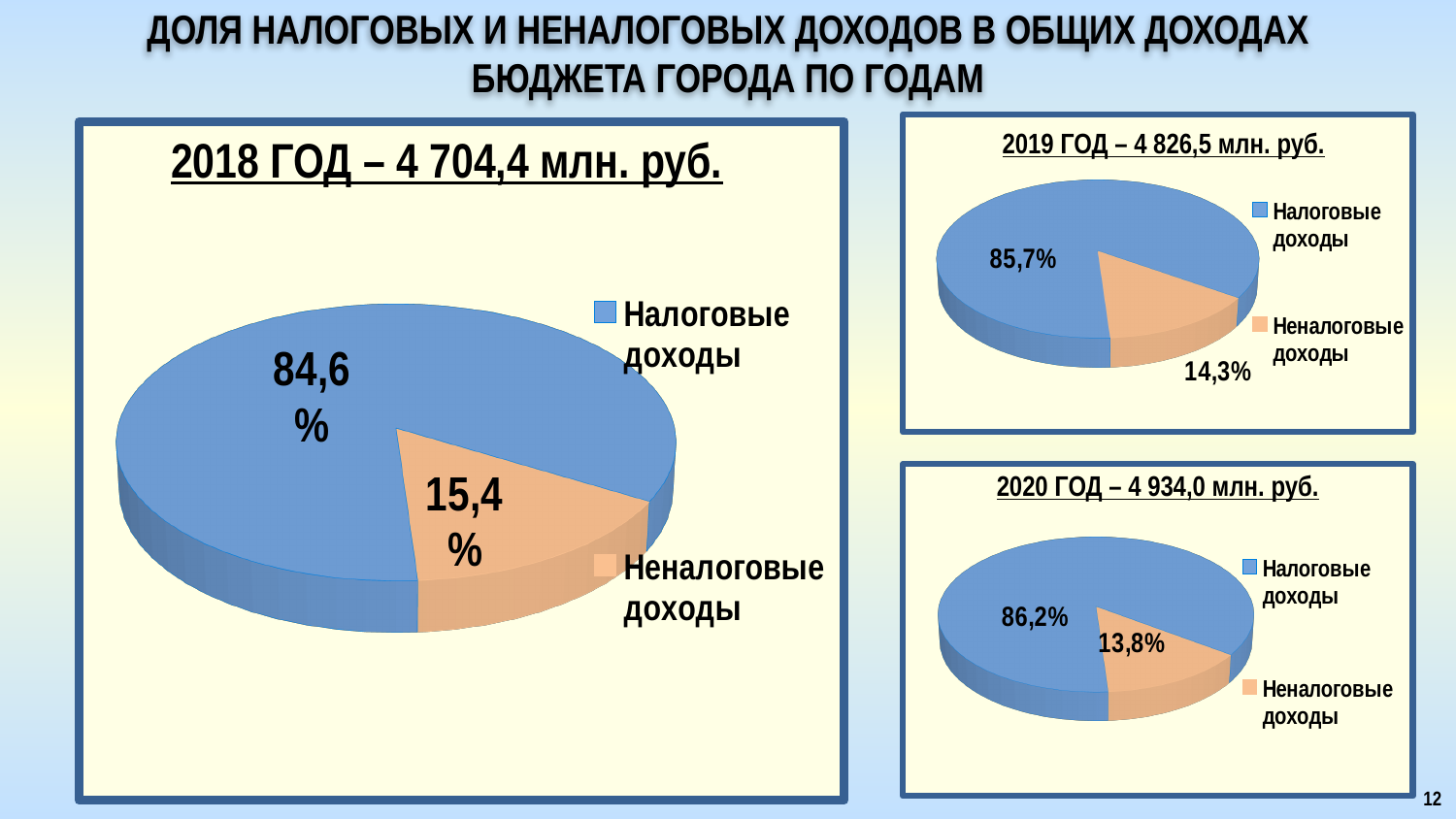
In the 2020 chart (2020 ГОД – 4 934,0 млн. руб.), what share of the pie is Налоговые доходы? 86,2% In the 2018 chart (2018 ГОД – 4 704,4 млн. руб.), what share of the pie is Налоговые доходы? 84,6% In the 2020 chart (2020 ГОД – 4 934,0 млн. руб.), which slice is the largest? Налоговые доходы In the 2019 chart (2019 ГОД – 4 826,5 млн. руб.), which slice is the smallest? Неналоговые доходы In the 2019 chart (2019 ГОД – 4 826,5 млн. руб.), what share of the pie is Неналоговые доходы? 14,3% What kind of chart is used for the 2018 data on the left of the slide? Pie chart How many entries does the legend of the 2020 chart (2020 ГОД – 4 934,0 млн. руб.) list? 2 How many slices does the 2019 pie chart (2019 ГОД – 4 826,5 млн. руб.) have? 2 In the 2018 chart (2018 ГОД – 4 704,4 млн. руб.), what is the difference in percentage points between Налоговые доходы and Неналоговые доходы? 69,2